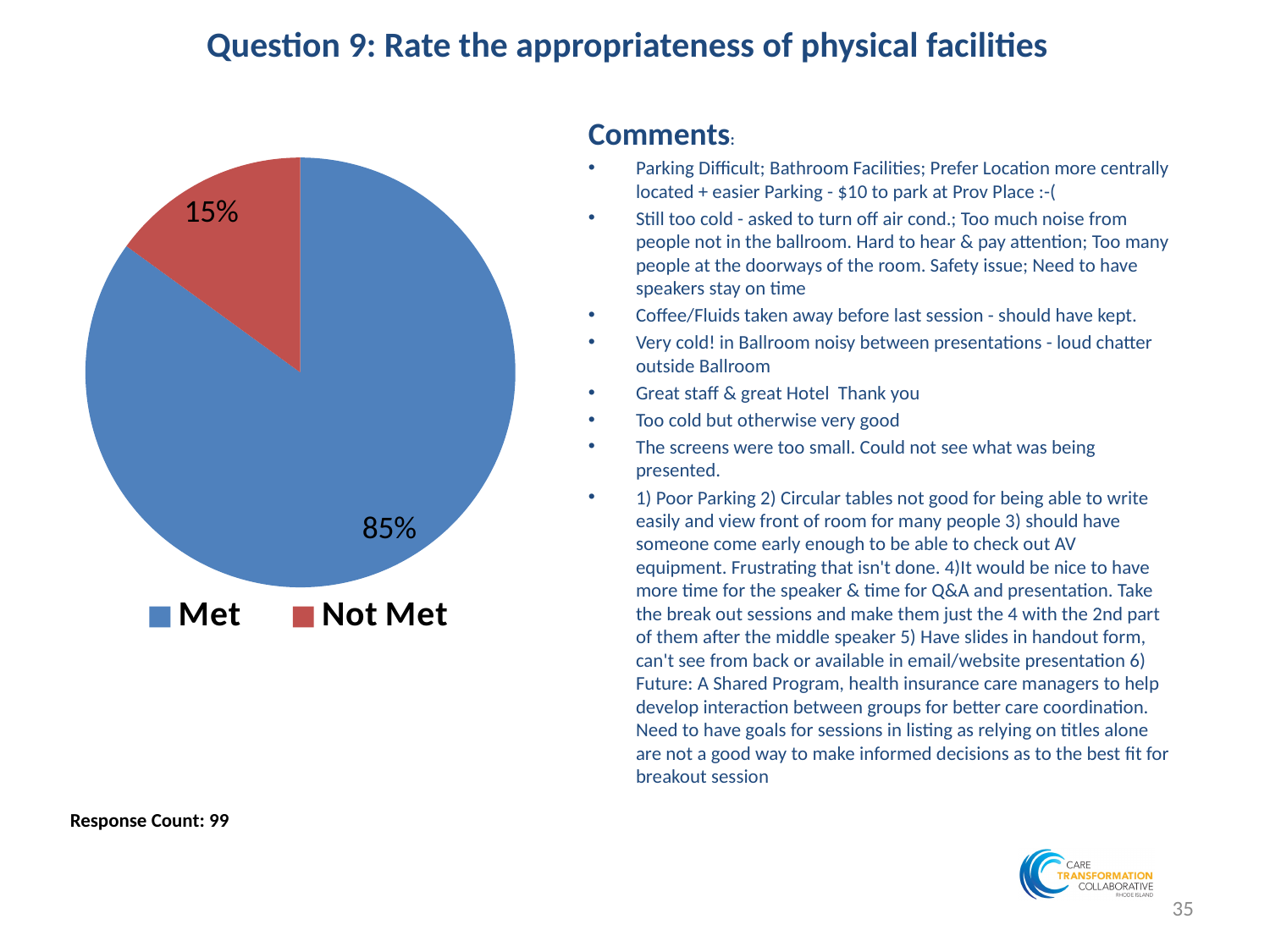
What colour is the "Not Met" slice in the pie chart? red What share of the pie does the "Met" slice represent? 85% What percentage of responses are labelled "Not Met" in the pie chart? 15% Which slice of the pie chart is the smallest? Not Met What percentage of responses are labelled "Met" in the pie chart? 85% Which is larger in the pie chart, "Met" or "Not Met"? Met What is the difference in percentage points between the "Met" and "Not Met" slices? 70 Which slice of the pie chart is the largest? Met How many slices does the pie chart have? 2 How many entries does the pie chart's legend list? 2 What kind of chart is shown on the slide? pie chart What is the response count shown below the pie chart? 99